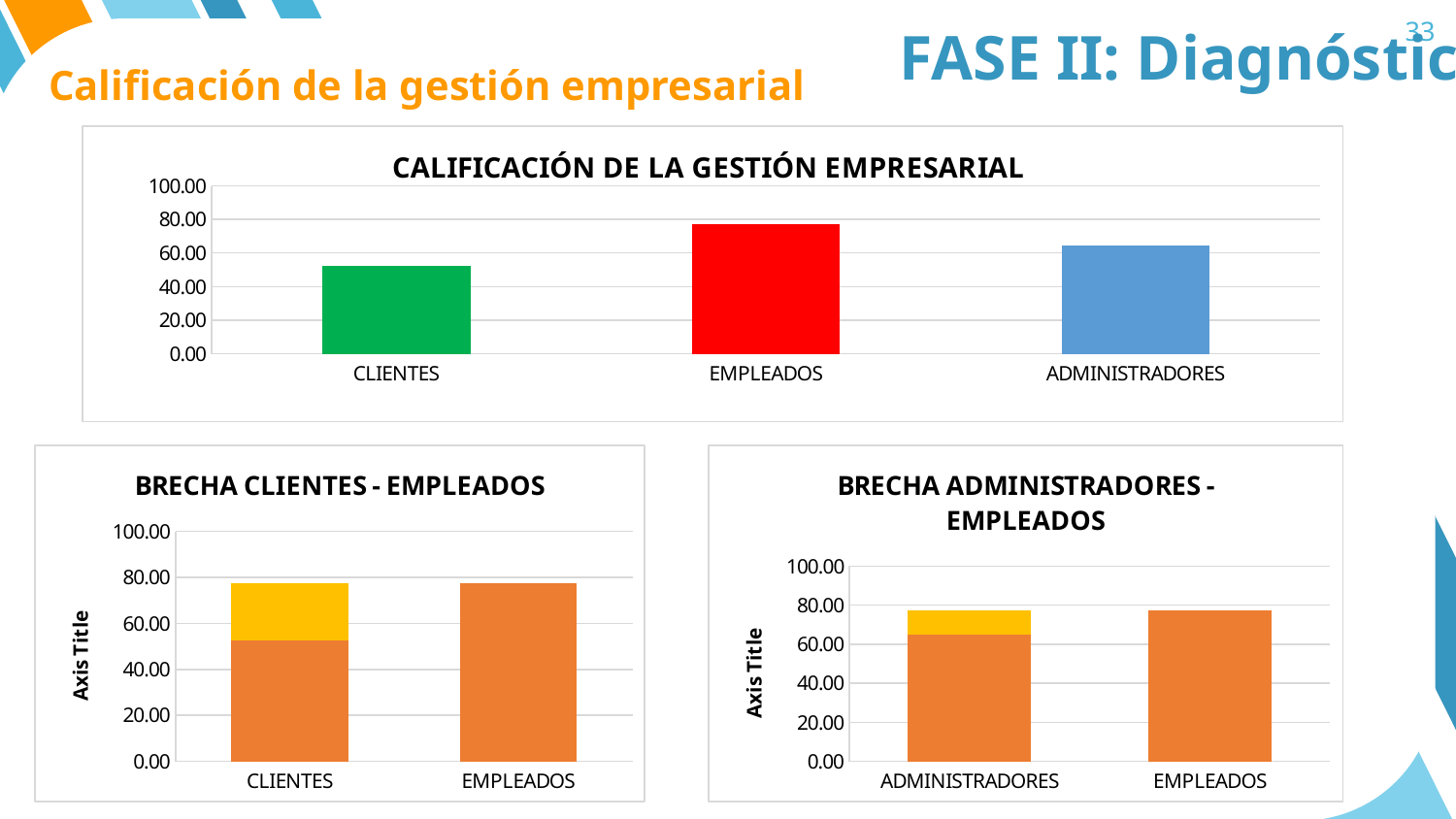
What kind of chart is the one titled CALIFICACIÓN DE LA GESTIÓN EMPRESARIAL? bar chart In the chart titled CALIFICACIÓN DE LA GESTIÓN EMPRESARIAL, is the value for EMPLEADOS greater or less than 60.00? greater In the chart titled BRECHA CLIENTES - EMPLEADOS, how many categories are shown on the x axis? 2 What is the y-axis title of the chart titled BRECHA CLIENTES - EMPLEADOS? Axis Title In the chart titled CALIFICACIÓN DE LA GESTIÓN EMPRESARIAL, which is larger, the value for ADMINISTRADORES or the value for CLIENTES? ADMINISTRADORES In the chart titled CALIFICACIÓN DE LA GESTIÓN EMPRESARIAL, is the value for ADMINISTRADORES greater or less than 80.00? less In the chart titled CALIFICACIÓN DE LA GESTIÓN EMPRESARIAL, which category has the lowest value? CLIENTES In the chart titled CALIFICACIÓN DE LA GESTIÓN EMPRESARIAL, what colour is the EMPLEADOS bar? red In the chart titled CALIFICACIÓN DE LA GESTIÓN EMPRESARIAL, is the value for CLIENTES greater or less than 60.00? less In the chart titled CALIFICACIÓN DE LA GESTIÓN EMPRESARIAL, which category has the highest value? EMPLEADOS How many categories are shown in the chart titled CALIFICACIÓN DE LA GESTIÓN EMPRESARIAL? 3